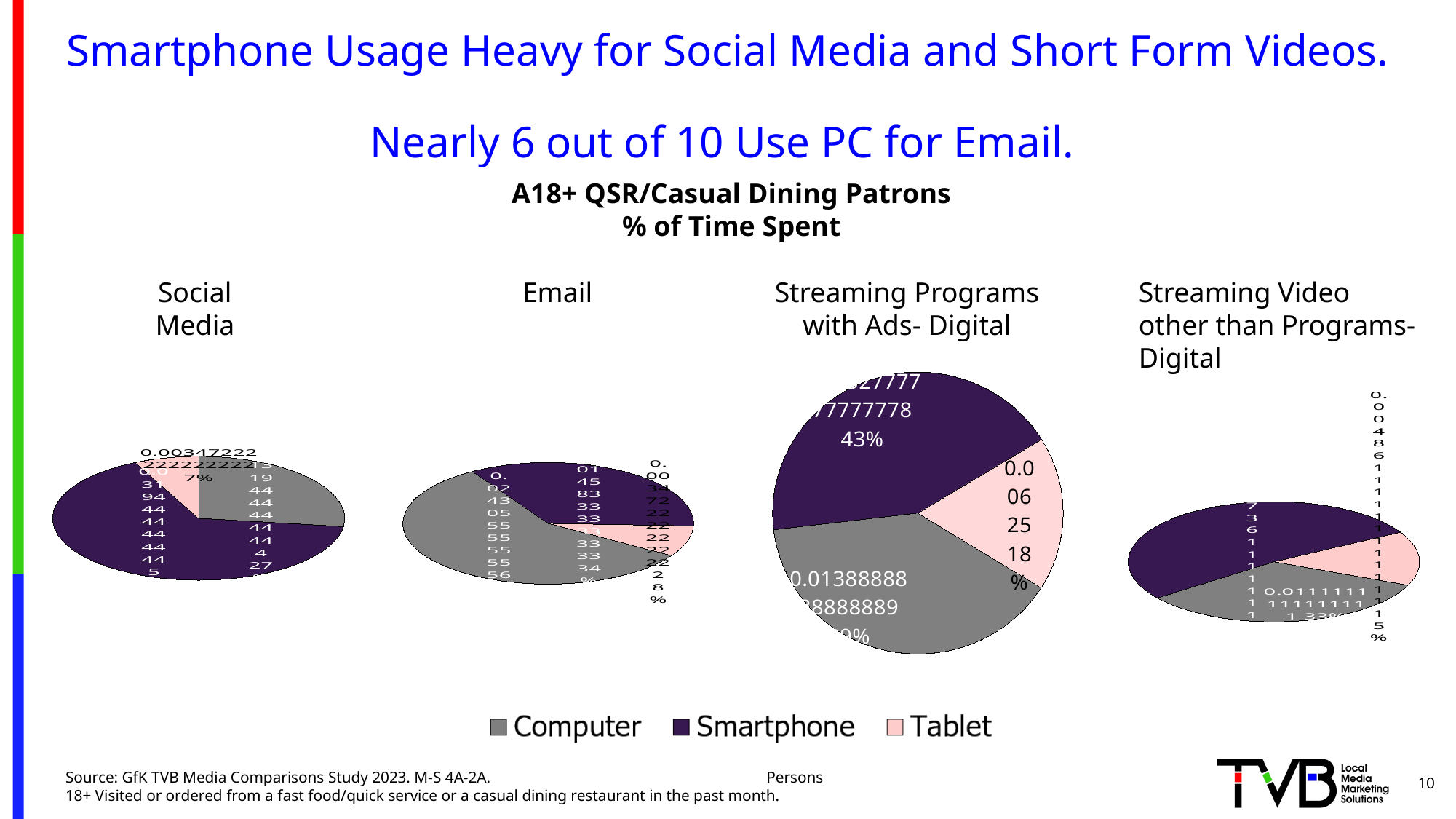
What kind of charts are shown on the slide? Pie charts In the Streaming Video other than Programs- Digital pie chart, which device has the largest slice? Smartphone In the Social Media pie chart, which device has the largest slice? Smartphone In the Streaming Programs with Ads- Digital pie chart, what share of time spent is on Smartphone? 43% How many pie charts are on the slide? 4 In the Streaming Programs with Ads- Digital pie chart, what share of time spent is on Tablet? 18% Which legend entry is shown in dark purple? Smartphone In the Social Media pie chart, what share of time spent is on Tablet? 7% In the Streaming Programs with Ads- Digital pie chart, which is larger, the Smartphone slice or the Tablet slice? Smartphone How many series does the legend list? 3 In the Streaming Programs with Ads- Digital pie chart, what is the difference between the Smartphone share and the Tablet share? 25 percentage points In the Email pie chart, which device has the largest slice? Computer